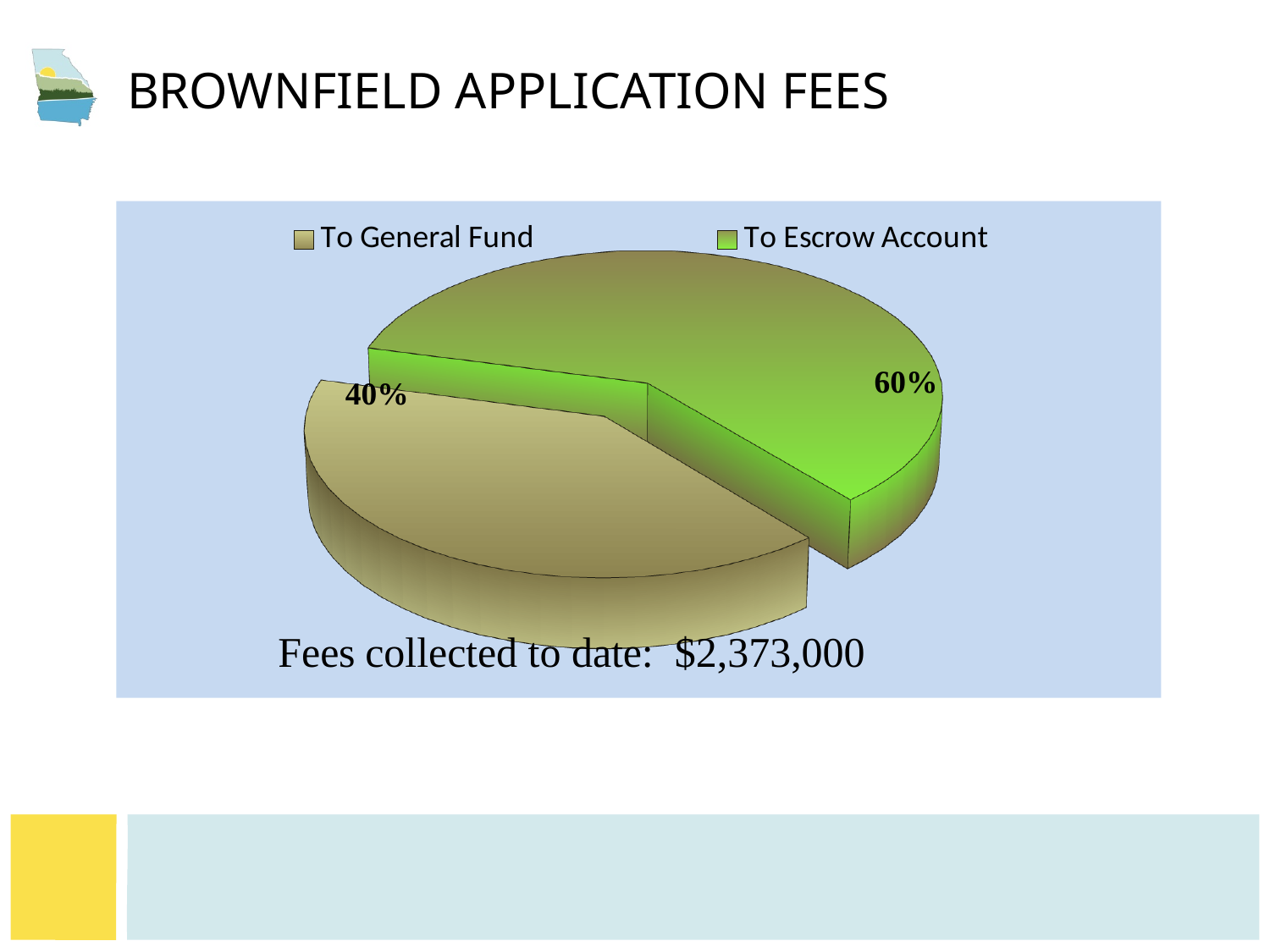
What kind of chart is shown on the slide? Pie chart How many entries does the legend list? 2 How many slices does the pie chart have? 2 What share of the pie goes to the General Fund? 40% Which legend entry is shown in bright green? To Escrow Account What share of the pie goes to the Escrow Account? 60% What is the difference in percentage points between the Escrow Account share and the General Fund share? 20% What is the total of fees collected to date shown on the chart? $2,373,000 Which slice of the pie is the smallest? To General Fund Which slice of the pie is the largest? To Escrow Account Which is larger: the share to the General Fund or the share to the Escrow Account? To Escrow Account